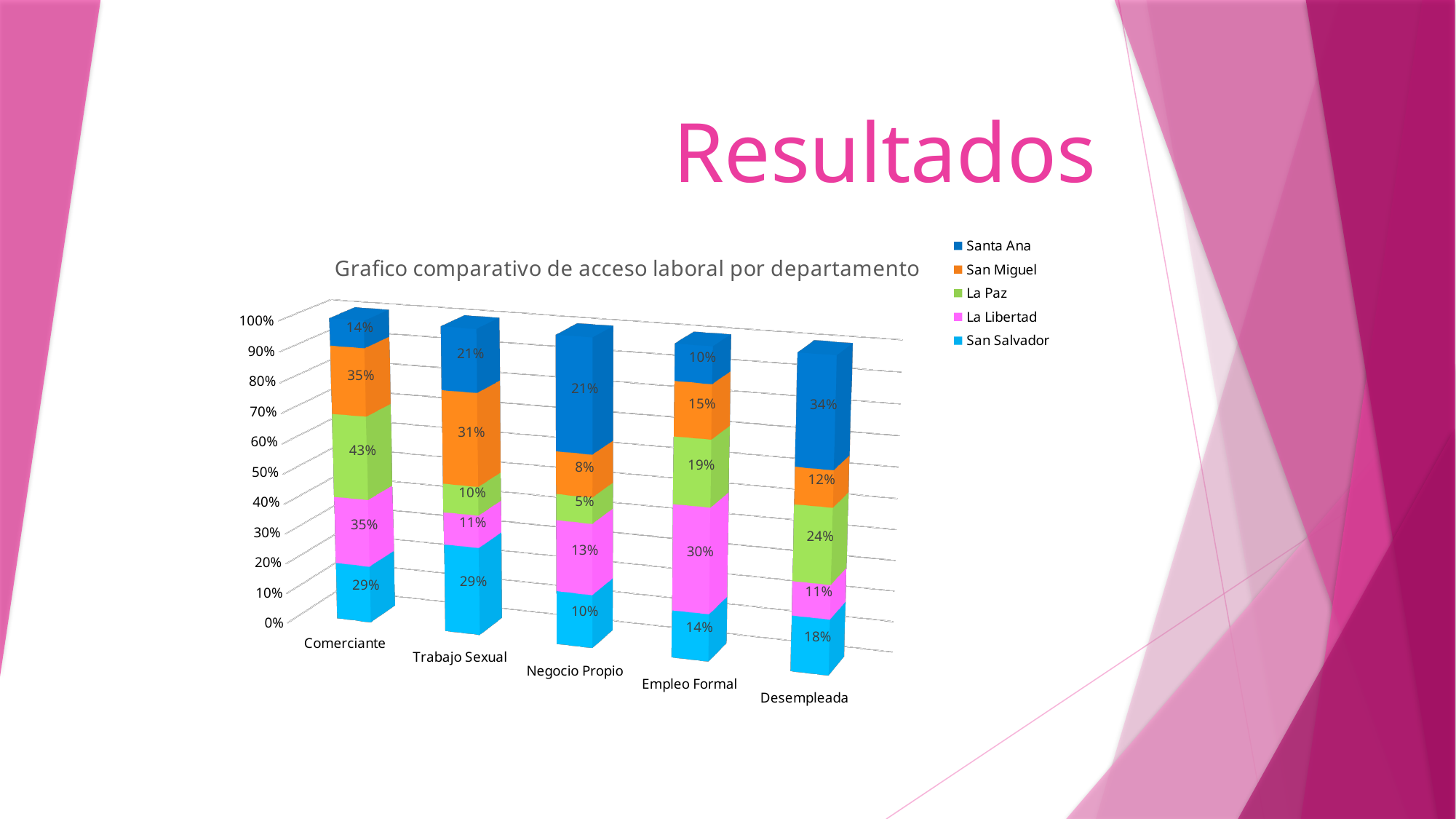
What is the value for La Paz in the Comerciante category? 43% What is the difference between the Santa Ana values for Desempleada and Empleo Formal? 24 percentage points Which category has the highest value for San Miguel? Comerciante What is the title of the chart? Grafico comparativo de acceso laboral por departamento What kind of chart is shown on the slide? Stacked bar chart Which is larger for San Miguel: Trabajo Sexual or Empleo Formal? Trabajo Sexual Which category has the lowest value for La Paz? Negocio Propio What is the value for Santa Ana in the Desempleada category? 34% What is the value for La Libertad in the Empleo Formal category? 30% How many series does the legend list? 5 What is the value for San Salvador in the Negocio Propio category? 10% How many categories are shown on the x axis? 5